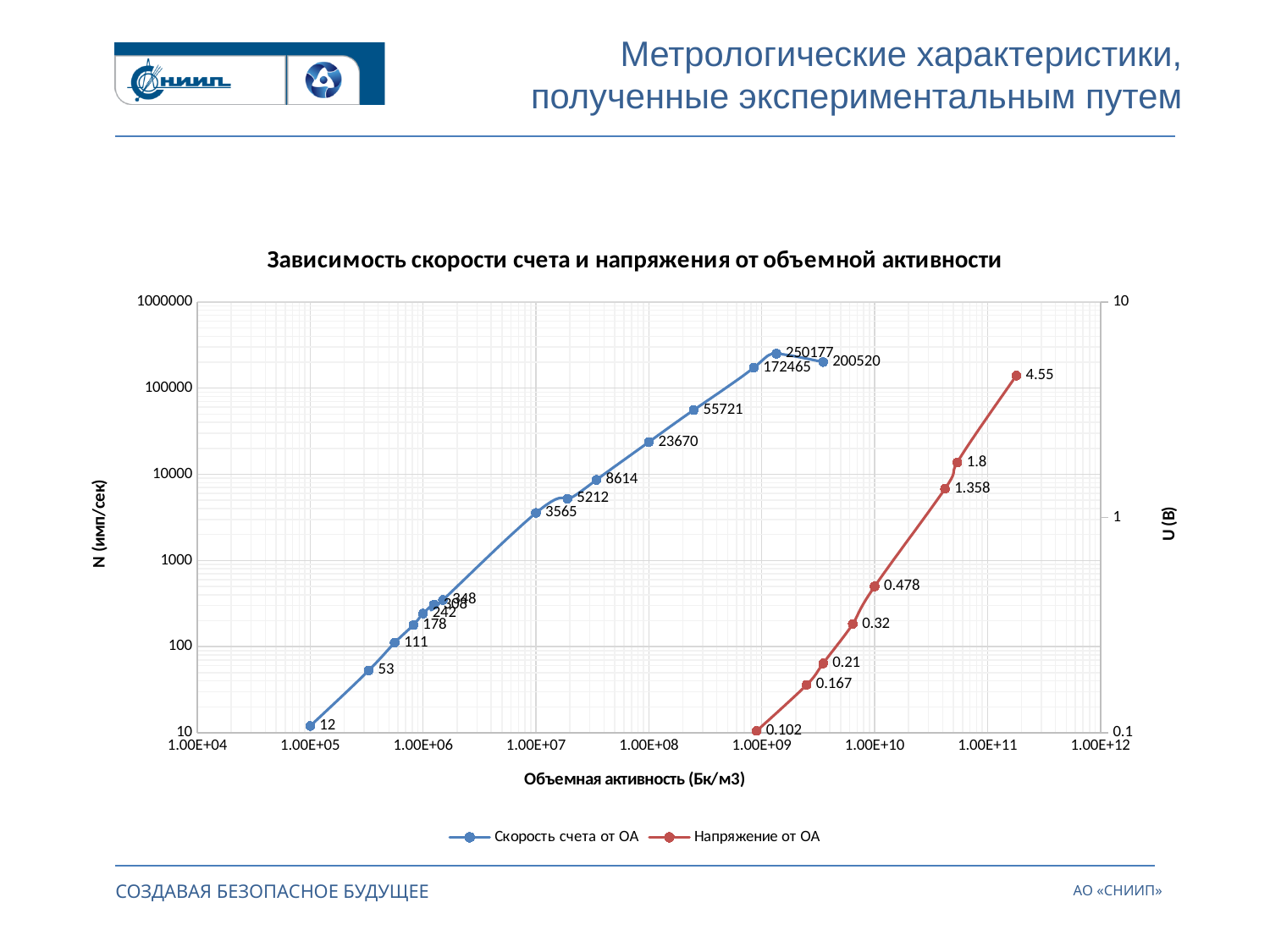
Which is larger on the 'Скорость счета от ОА' series: the point labelled 55721 or the point labelled 23670? 55721 What is the highest value labelled on the 'Скорость счета от ОА' series? 250177 What is the difference between the two highest labelled values on the 'Напряжение от ОА' series (4.55 and 1.8)? 2.75 What is the lowest value labelled on the 'Напряжение от ОА' series? 0.102 What is the lowest value labelled on the 'Скорость счета от ОА' series? 12 What is the difference between the labelled values 250177 and 200520 on the 'Скорость счета от ОА' series? 49657 How many series does the legend list? 2 Do the values of the 'Напряжение от ОА' series rise or fall as volumetric activity increases along the x axis? rise How many data points are plotted on the 'Напряжение от ОА' series? 8 What is the title of the x axis of the chart? Объемная активность (Бк/м3) What kind of chart is shown on the slide? line chart What is the highest value labelled on the 'Напряжение от ОА' series? 4.55